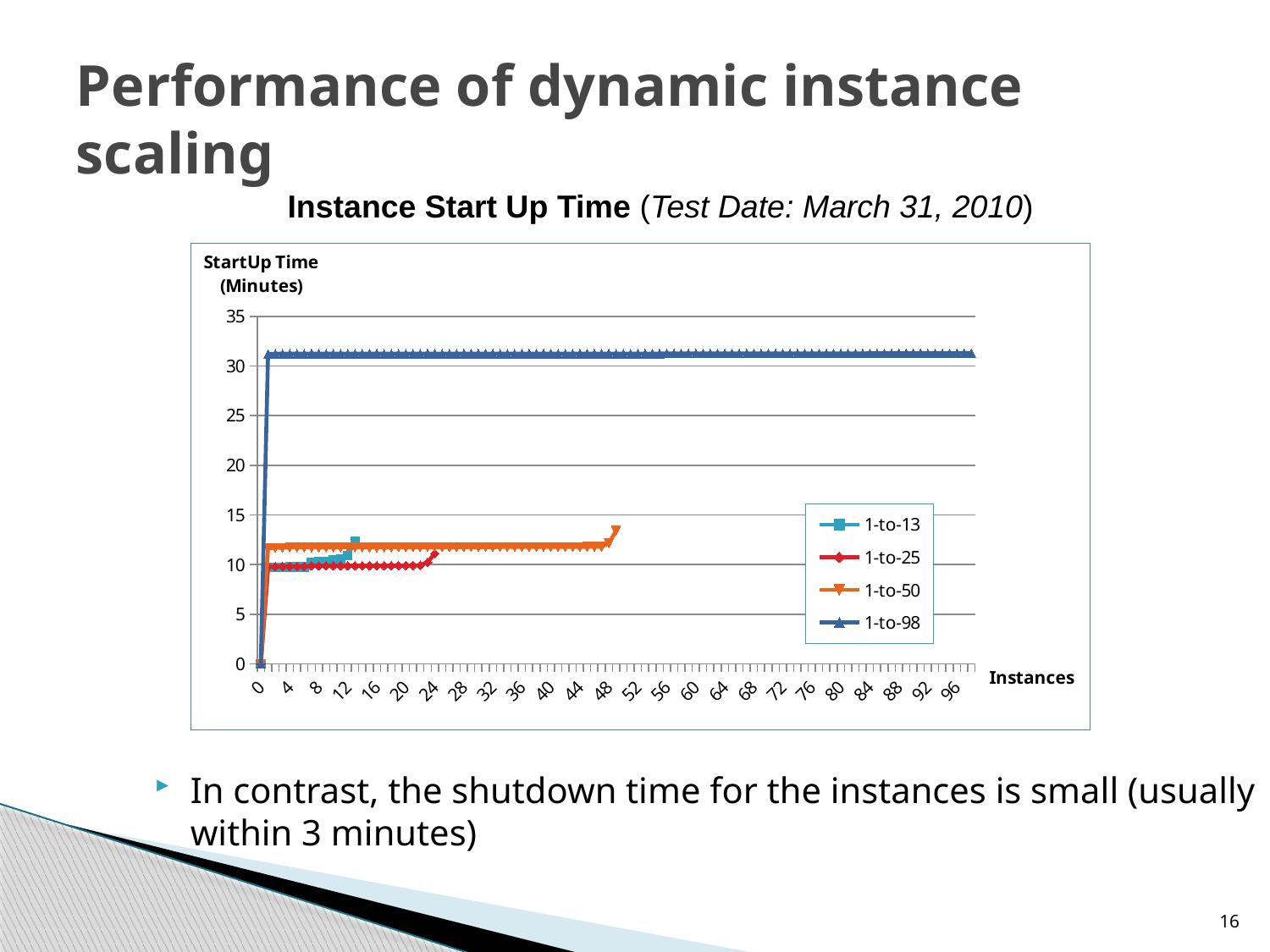
What kind of chart is shown on the slide? line chart Is the start-up time for the 1-to-98 series greater or less than 35 minutes? less Which series has the highest start-up time across the instances? 1-to-98 What is the highest value shown on the vertical axis? 35 Is the start-up time for the 1-to-98 series greater or less than 30 minutes? greater How many series does the legend list? 4 Is the plateau start-up time for the 1-to-50 series greater or less than 15 minutes? less What is the label of the horizontal axis? Instances What is the label of the vertical axis? StartUp Time (Minutes) Which series has a higher start-up time, 1-to-98 or 1-to-25? 1-to-98 Which series has a higher start-up time, 1-to-50 or 1-to-25? 1-to-50